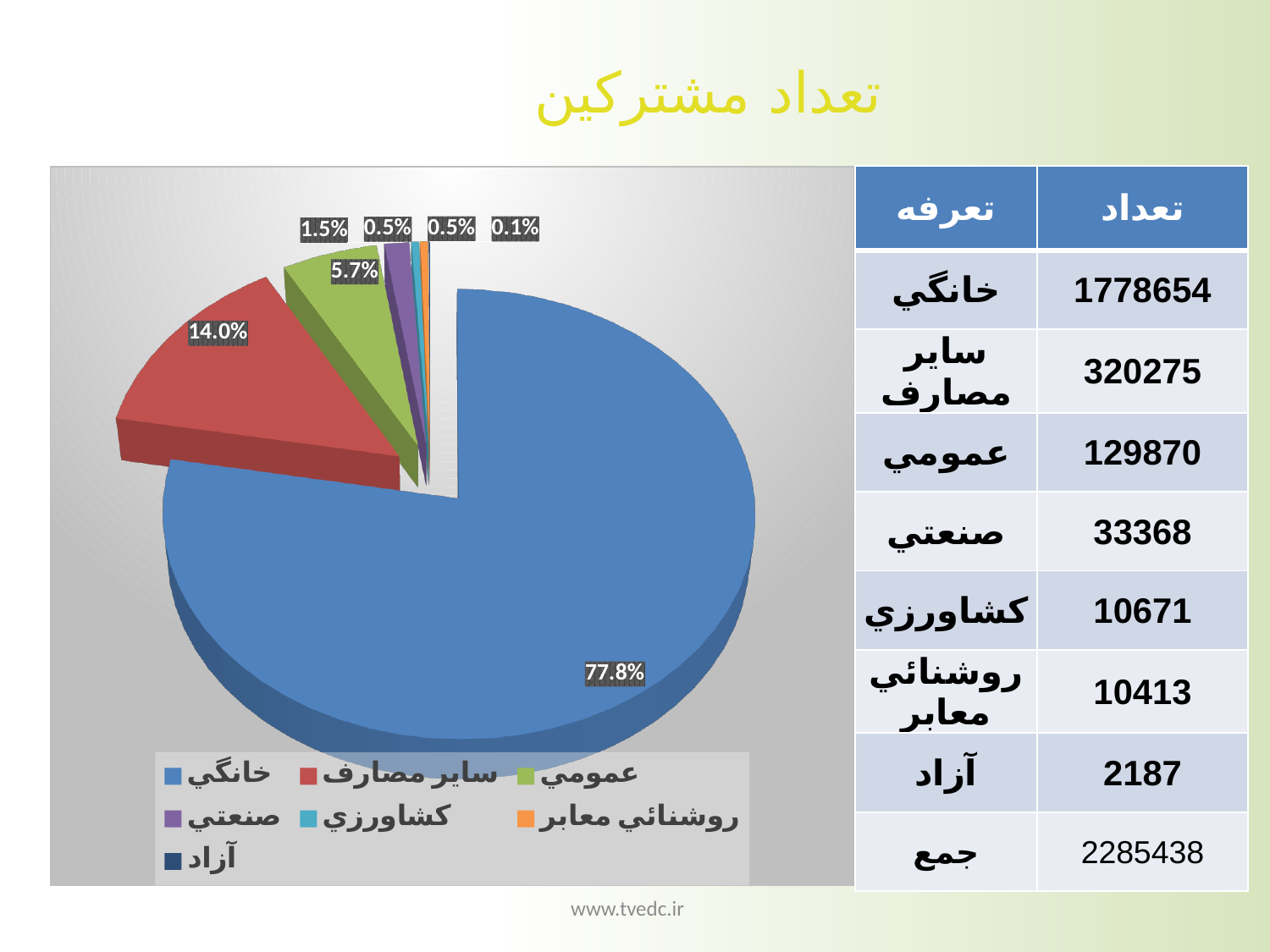
What share of the pie does the ساير مصارف slice represent? 14.0% What share of the pie does the خانگي slice represent? 77.8% What share of the pie does the صنعتي slice represent? 1.5% What is the difference in percentage points between the خانگي slice and the ساير مصارف slice? 63.8% Which slice is larger, ساير مصارف or عمومي? ساير مصارف How many entries does the legend list? 7 Which category has the smallest slice of the pie? آزاد Which category has the largest slice of the pie? خانگي What kind of chart is shown on the slide? pie chart How many slices does the pie chart have? 7